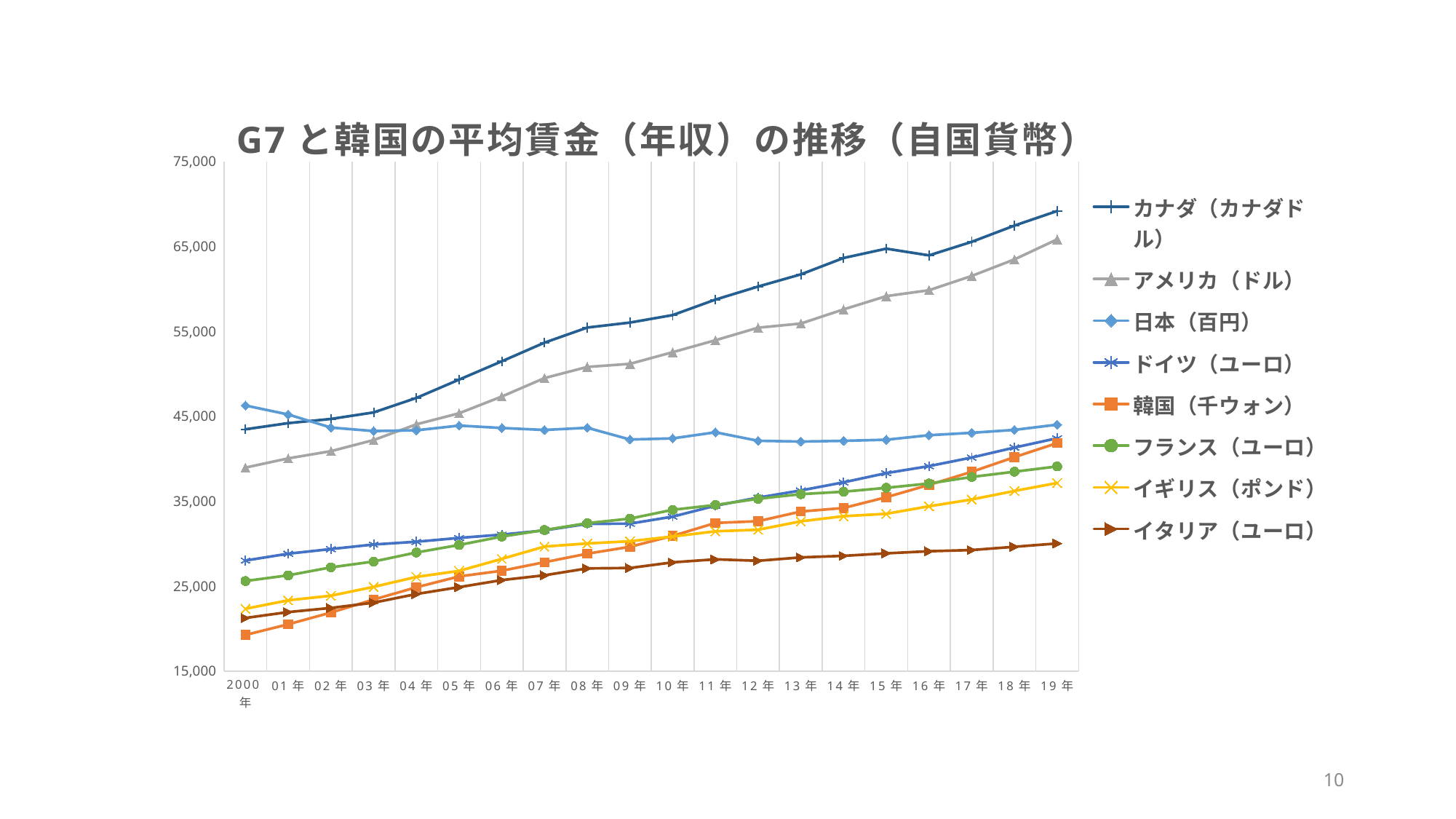
In 2000年, which is larger: the value for 日本（百円） or the value for カナダ（カナダドル）? 日本（百円） Which series has the lowest value in 2000年? 韓国（千ウォン） Does the value for 韓国（千ウォン） rise or fall from 2000年 to 19年? rise How many series does the legend list? 8 Is the value for アメリカ（ドル） in 10年 greater or less than 55,000? less What is the title of the chart? G7 と韓国の平均賃金（年収）の推移（自国貨幣） Is the value for カナダ（カナダドル） in 19年 greater or less than 65,000? greater Which series has the lowest value in 19年? イタリア（ユーロ） What kind of chart is shown on the slide? line chart Is the value for イタリア（ユーロ） in 19年 greater or less than 35,000? less Which series has the highest value in 19年? カナダ（カナダドル） How many years (points) are plotted along the x axis? 20